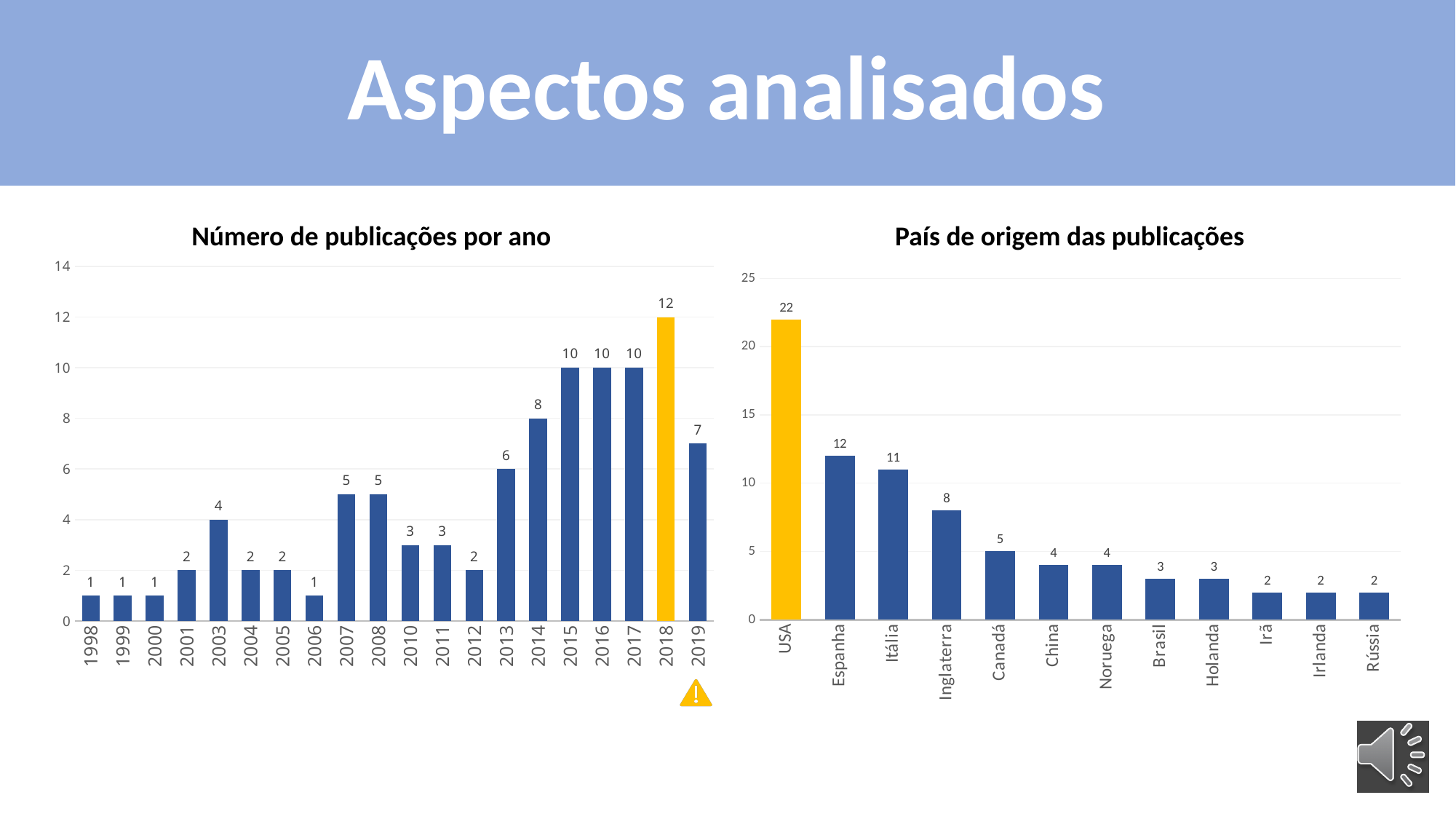
In the chart 'País de origem das publicações', what is the value for Espanha? 12 In the chart 'Número de publicações por ano', which is larger, the value for 2013 or the value for 2007? 2013 In the chart 'País de origem das publicações', how many countries are shown? 12 In the chart 'Número de publicações por ano', which year has the highest value? 2018 In the chart 'País de origem das publicações', what is the difference between the values for USA and Itália? 11 In the chart 'Número de publicações por ano', how many years are shown on the x axis? 20 In the chart 'País de origem das publicações', which bar is coloured yellow instead of blue? USA In the chart 'Número de publicações por ano', what is the difference between the values for 2018 and 2019? 5 In the chart 'Número de publicações por ano', what is the value for 2018? 12 What kind of chart is 'País de origem das publicações'? Bar chart In the chart 'País de origem das publicações', which country has the highest value? USA In the chart 'Número de publicações por ano', what is the value for 2014? 8